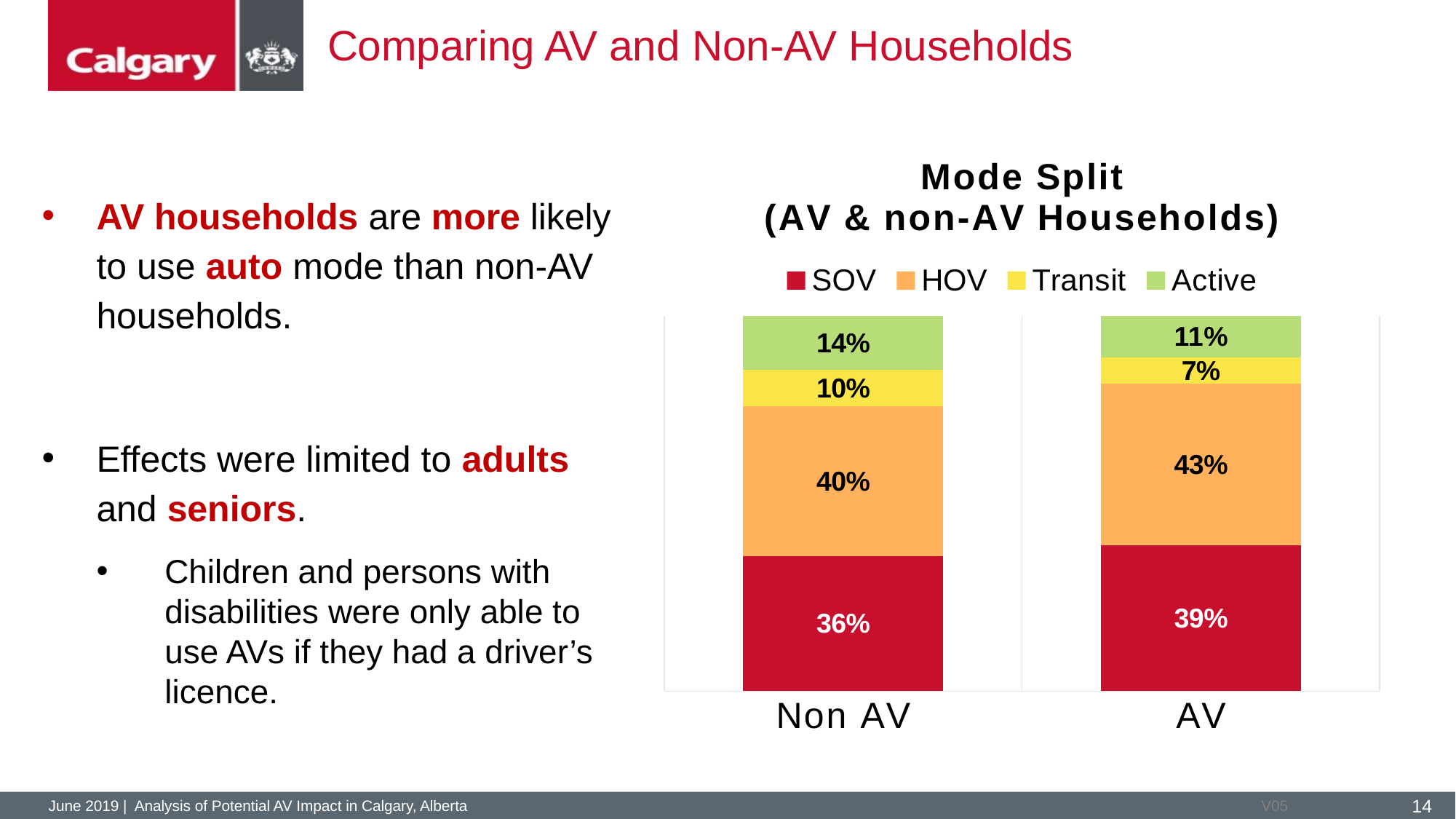
What is the difference between the Active share for Non AV households and for AV households? 3% What is the Transit share for AV households? 7% What is the Active share for Non AV households? 14% Which mode has the smallest share for AV households? Transit What type of chart is shown? Stacked bar chart How many series does the legend list? 4 What is the SOV share for Non AV households? 36% Which household type has the higher Transit share? Non AV Which household type has the higher SOV share? AV What is the difference between the HOV share for AV households and for Non AV households? 3% What is the HOV share for AV households? 43% Which mode has the largest share for Non AV households? HOV